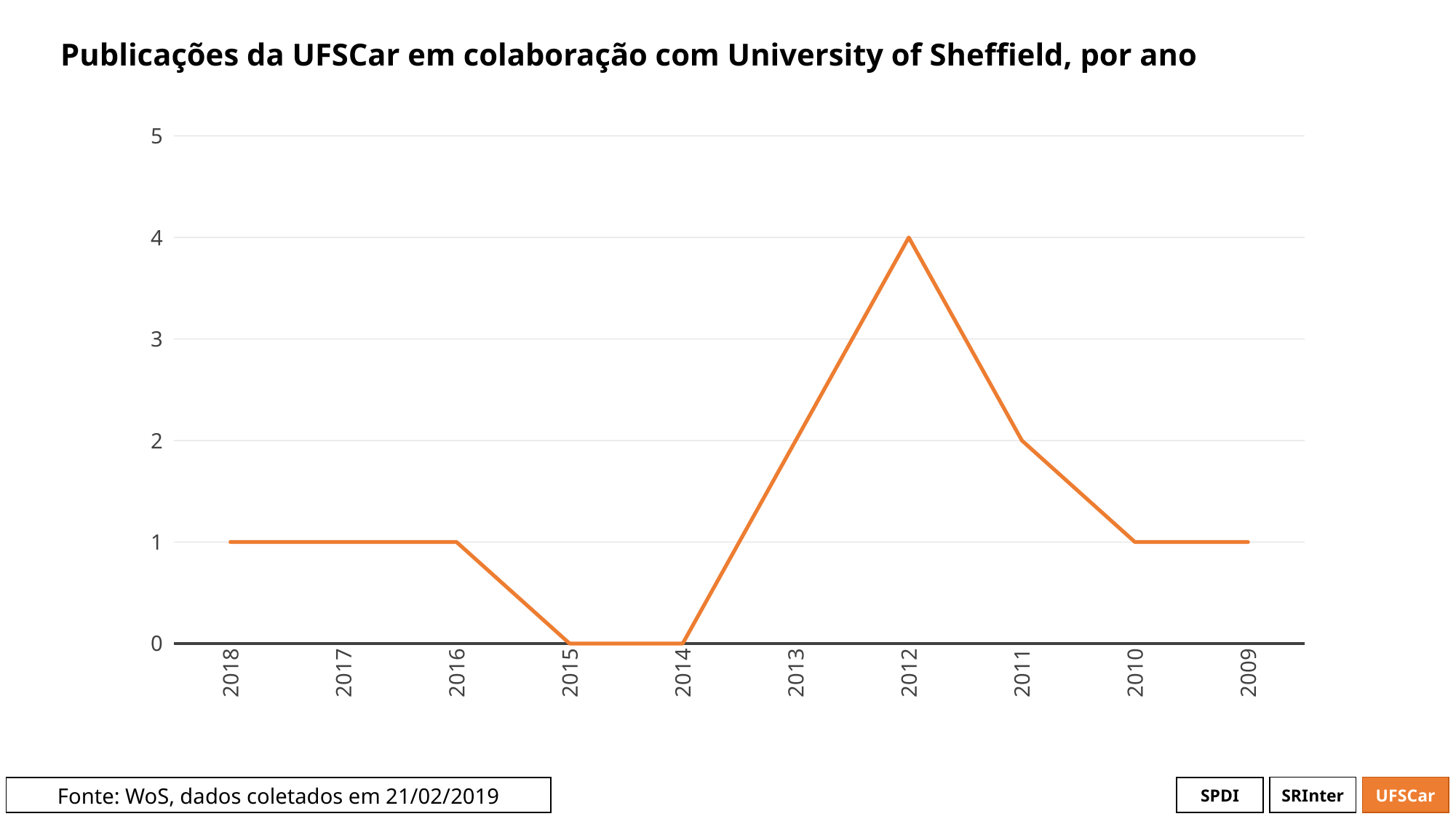
What is the title of the chart? Publicações da UFSCar em colaboração com University of Sheffield, por ano Which year has the highest value? 2012 How many years are shown on the x axis? 10 What is the value for 2018? 1 What is the value for 2015? 0 What is the value for 2012? 4 What is the difference between the values for 2012 and 2011? 2 What kind of chart is shown on the slide? line chart Which is larger, the value for 2012 or the value for 2010? 2012 Which years have a value of 0? 2015 and 2014 Do the values rise or fall from 2012 to 2009 along the x axis? fall What is the value for 2011? 2